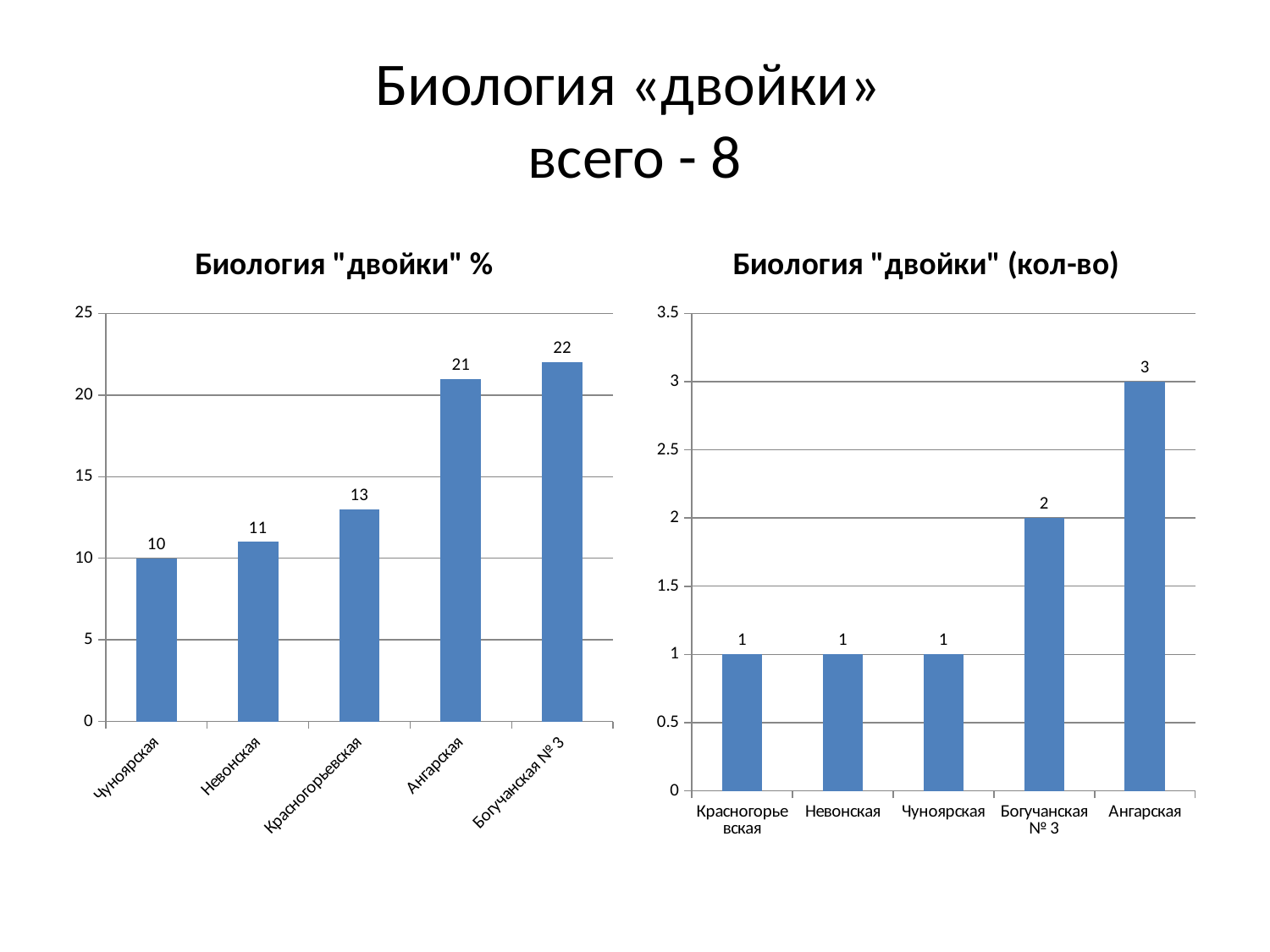
In the chart titled Биология "двойки" %, which category has the lowest value? Чуноярская In the chart titled Биология "двойки" %, what is the difference between the values for Богучанская № 3 and Красногорьевская? 9 In the chart titled Биология "двойки" %, how many categories are shown on the x axis? 5 In the chart titled Биология "двойки" (кол-во), which is larger, the value for Невонская or the value for Ангарская? Ангарская In the chart titled Биология "двойки" (кол-во), which category has the highest value? Ангарская In the chart titled Биология "двойки" %, what is the value for Чуноярская? 10 In the chart titled Биология "двойки" (кол-во), what is the value for Богучанская № 3? 2 In the chart titled Биология "двойки" %, do the values rise or fall from left to right along the x axis? rise In the chart titled Биология "двойки" (кол-во), what is the difference between the values for Ангарская and Чуноярская? 2 In the chart titled Биология "двойки" %, what is the value for Ангарская? 21 In the chart titled Биология "двойки" %, which category has the highest value? Богучанская № 3 What kind of chart is the chart titled Биология "двойки" (кол-во)? bar chart